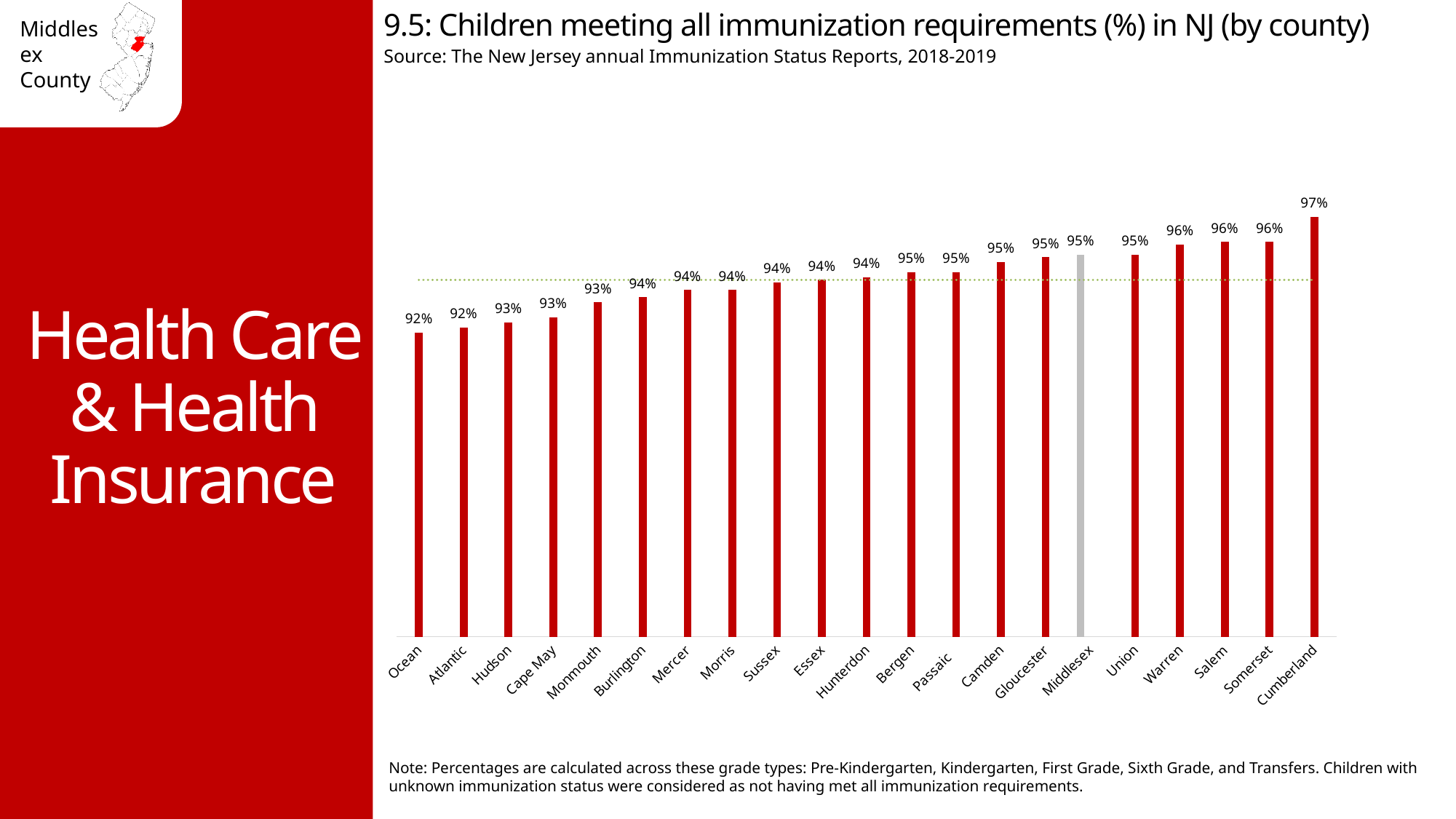
What is the difference in percentage points between Middlesex and Atlantic counties? 3 percentage points Which has a higher value, Warren or Hudson? Warren What is the value for Hunterdon County? 94% Which county has the highest percentage of children meeting all immunization requirements? Cumberland What is the value shown for Cumberland County? 97% What kind of chart is used on this slide? Bar chart What is the difference in percentage points between Cumberland and Ocean counties? 5 percentage points What percentage is shown for Ocean County? 92% Do the values rise or fall moving from left to right along the x axis? Rise Which county's bar is coloured grey instead of red? Middlesex How many counties are shown in the chart? 21 What percentage of children in Middlesex County met all immunization requirements? 95%